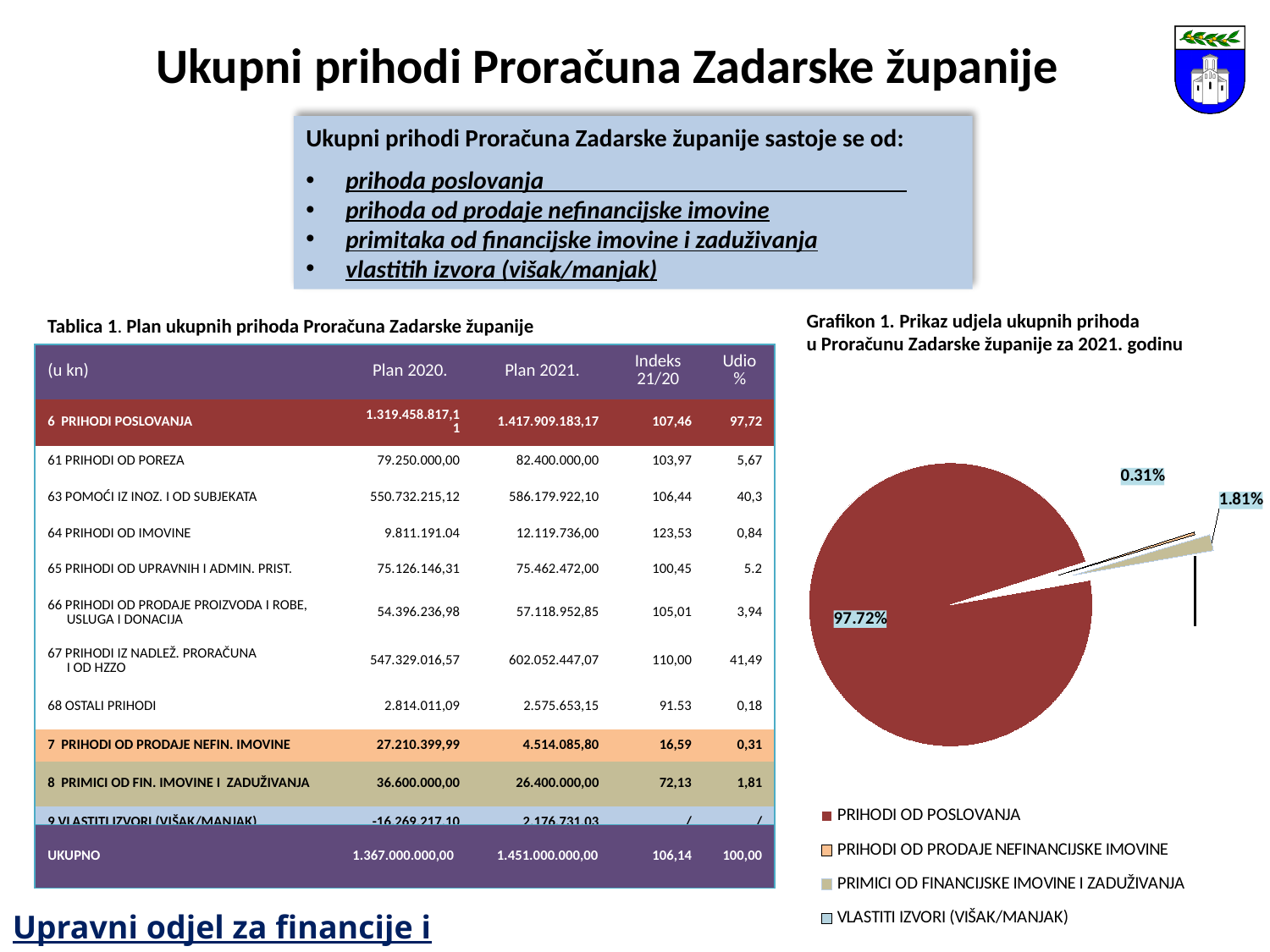
In the pie chart, what is the difference between the share of PRIMICI OD FINANCIJSKE IMOVINE I ZADUŽIVANJA and the share of PRIHODI OD PRODAJE NEFINANCIJSKE IMOVINE? 1.50% Which labeled slice in the pie chart has the smallest share? PRIHODI OD PRODAJE NEFINANCIJSKE IMOVINE In the pie chart, what colour is the slice for PRIHODI OD POSLOVANJA? dark red In the pie chart, what share is shown for PRIMICI OD FINANCIJSKE IMOVINE I ZADUŽIVANJA? 1.81% How many entries does the legend of the pie chart list? 4 Which category has the largest slice in the pie chart? PRIHODI OD POSLOVANJA In the pie chart, what is the difference between the share of PRIHODI OD POSLOVANJA and the share of PRIMICI OD FINANCIJSKE IMOVINE I ZADUŽIVANJA? 95.91% In the pie chart, what share is shown for PRIHODI OD PRODAJE NEFINANCIJSKE IMOVINE? 0.31% In the pie chart, what share is shown for PRIHODI OD POSLOVANJA? 97.72% In the pie chart, which is larger: the share of PRIMICI OD FINANCIJSKE IMOVINE I ZADUŽIVANJA or the share of PRIHODI OD PRODAJE NEFINANCIJSKE IMOVINE? PRIMICI OD FINANCIJSKE IMOVINE I ZADUŽIVANJA What kind of chart is Grafikon 1 on the slide? pie chart What is the title of the pie chart on the slide? Grafikon 1. Prikaz udjela ukupnih prihoda u Proračunu Zadarske županije za 2021. godinu